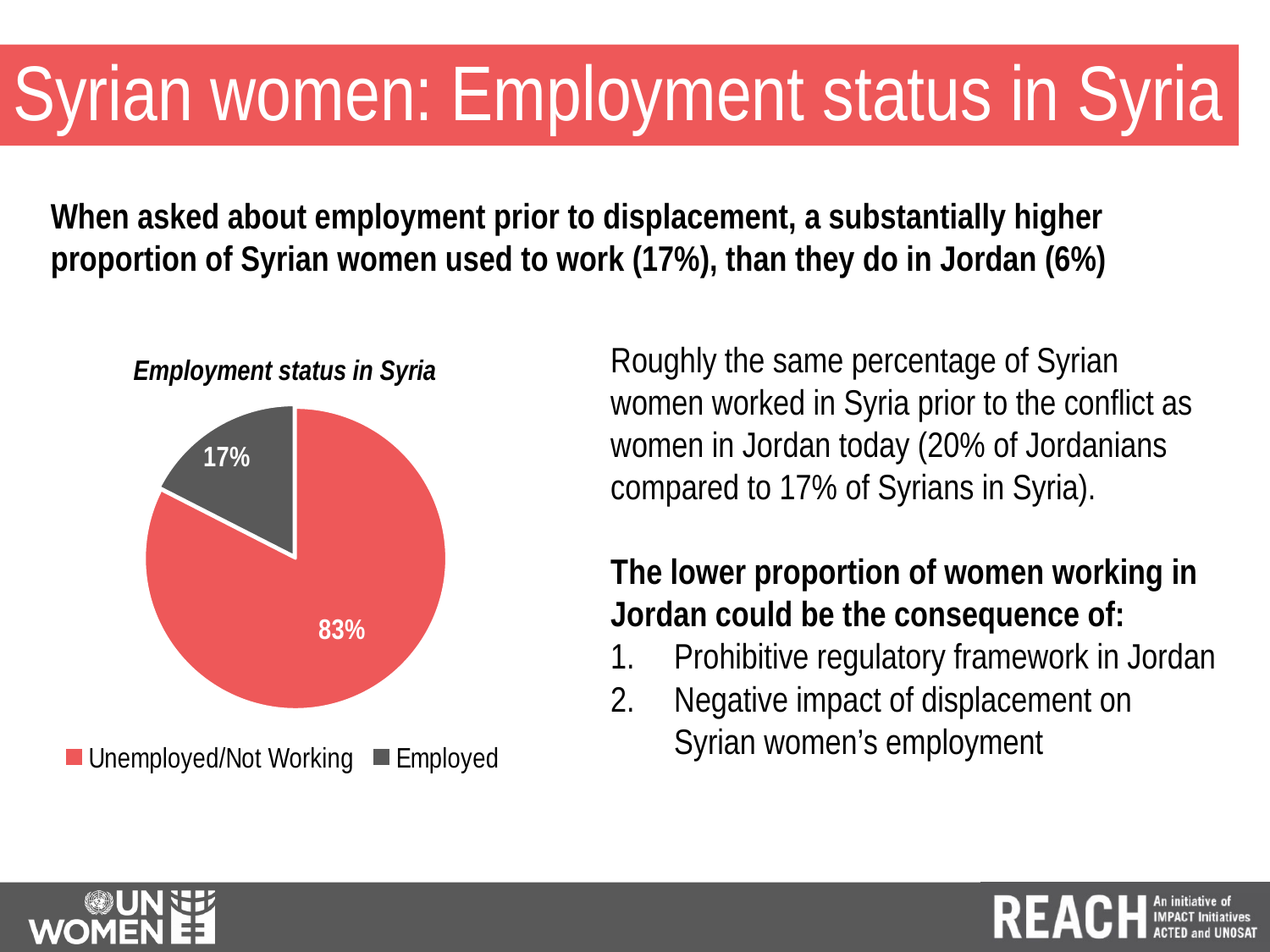
How many slices does the pie chart have? 2 Which category has the smallest share of the pie? Employed What colour is the Employed slice? Grey What kind of chart is shown on the slide? Pie chart What is the difference in percentage points between the Unemployed/Not Working slice and the Employed slice? 66 What percentage of the pie is labelled Unemployed/Not Working? 83% What share of the pie does the Employed slice represent? 17% How many entries does the legend list? 2 What percentage of the pie is labelled Employed? 17% Which is larger, the Employed slice or the Unemployed/Not Working slice? Unemployed/Not Working What is the title of the chart? Employment status in Syria Which category has the largest share of the pie? Unemployed/Not Working